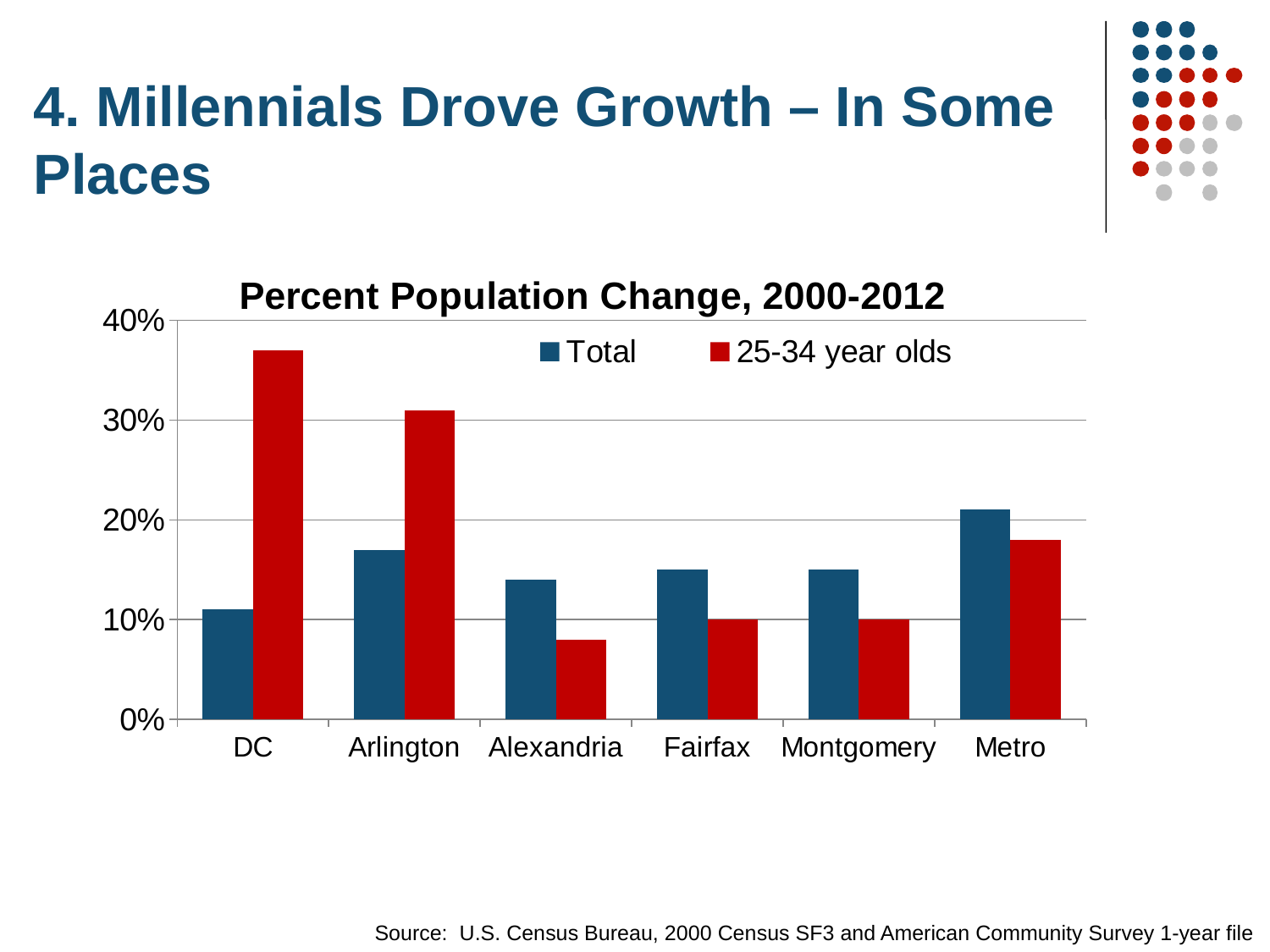
What kind of chart is shown on the slide? Bar chart Which jurisdiction has the highest percent population change for 25-34 year olds? DC For DC, which is larger: the Total change or the change for 25-34 year olds? 25-34 year olds For Alexandria, which is larger: the Total change or the change for 25-34 year olds? Total Is the value for 25-34 year olds in DC greater or less than 30%? greater How many jurisdictions (categories) are shown on the x axis? 6 Is the value for 25-34 year olds in Alexandria greater or less than 10%? less How many series does the legend list? 2 What is the title of the chart? Percent Population Change, 2000-2012 Which category has the lowest Total percent population change? DC Which category has the highest Total percent population change? Metro Which jurisdiction has the lowest percent population change for 25-34 year olds? Alexandria